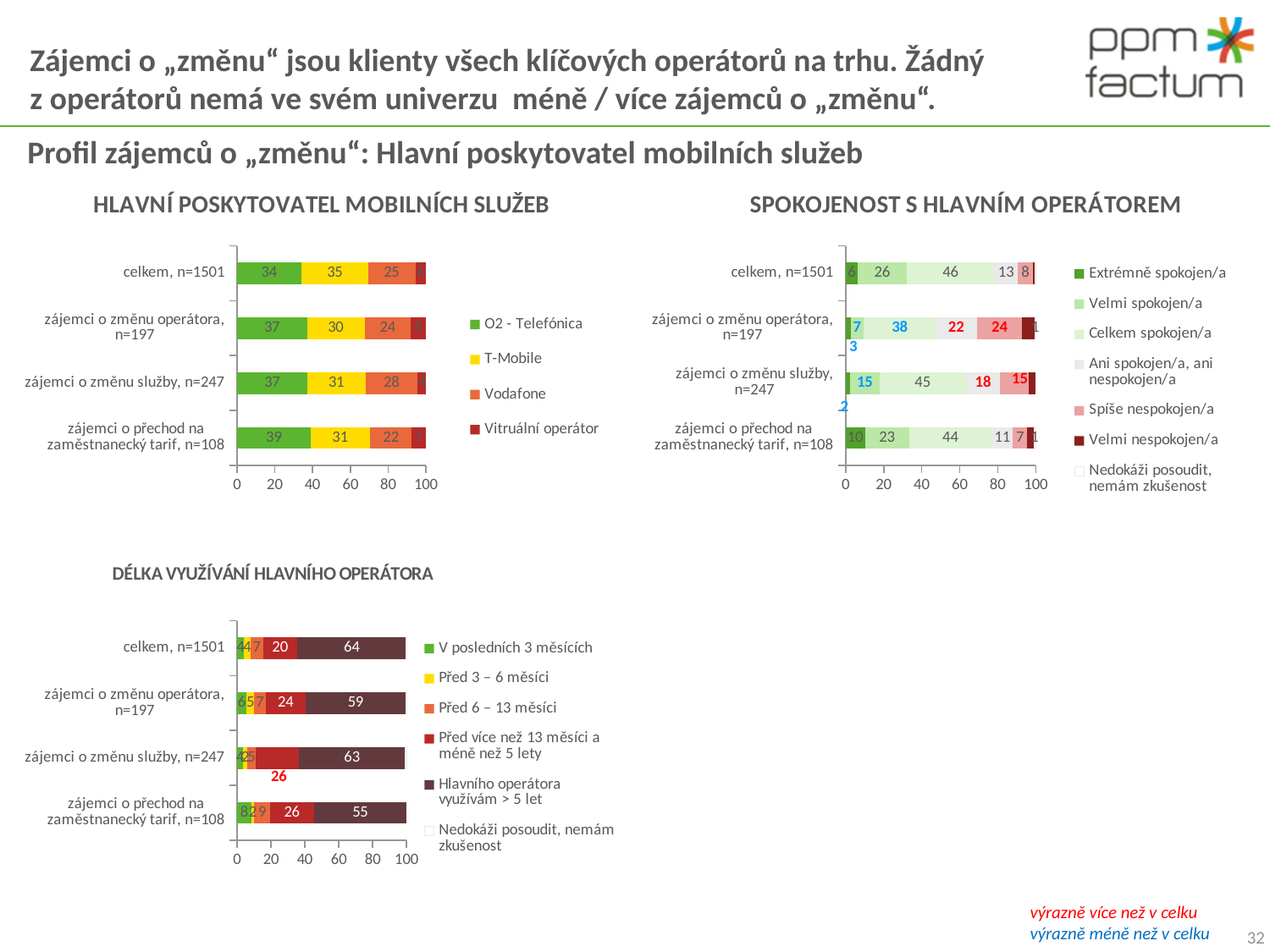
In the chart 'SPOKOJENOST S HLAVNÍM OPERÁTOREM', how many entries does the legend list? 7 In the chart 'DÉLKA VYUŽÍVÁNÍ HLAVNÍHO OPERÁTORA', which category has the lowest value for 'Hlavního operátora využívám > 5 let'? zájemci o přechod na zaměstnanecký tarif, n=108 In the chart 'SPOKOJENOST S HLAVNÍM OPERÁTOREM', what is the 'Celkem spokojen/a' value for 'celkem, n=1501'? 46 In the chart 'HLAVNÍ POSKYTOVATEL MOBILNÍCH SLUŽEB', what is the value for O2 - Telefónica in the 'celkem, n=1501' bar? 34 In the chart 'SPOKOJENOST S HLAVNÍM OPERÁTOREM', what is the 'Spíše nespokojen/a' value for 'zájemci o změnu operátora, n=197'? 24 What type of chart is 'DÉLKA VYUŽÍVÁNÍ HLAVNÍHO OPERÁTORA'? stacked bar chart In the chart 'DÉLKA VYUŽÍVÁNÍ HLAVNÍHO OPERÁTORA', what is the value for 'Hlavního operátora využívám > 5 let' in the 'celkem, n=1501' bar? 64 In the chart 'HLAVNÍ POSKYTOVATEL MOBILNÍCH SLUŽEB', what is the difference between the Vodafone values for 'zájemci o změnu služby, n=247' and 'zájemci o přechod na zaměstnanecký tarif, n=108'? 6 In the chart 'HLAVNÍ POSKYTOVATEL MOBILNÍCH SLUŽEB', what is the T-Mobile value for 'zájemci o změnu operátora, n=197'? 30 In the chart 'HLAVNÍ POSKYTOVATEL MOBILNÍCH SLUŽEB', which category has the highest O2 - Telefónica value? zájemci o přechod na zaměstnanecký tarif, n=108 In the chart 'SPOKOJENOST S HLAVNÍM OPERÁTOREM', which category has the highest 'Velmi spokojen/a' value? celkem, n=1501 In the chart 'HLAVNÍ POSKYTOVATEL MOBILNÍCH SLUŽEB', how many series does the legend list? 4